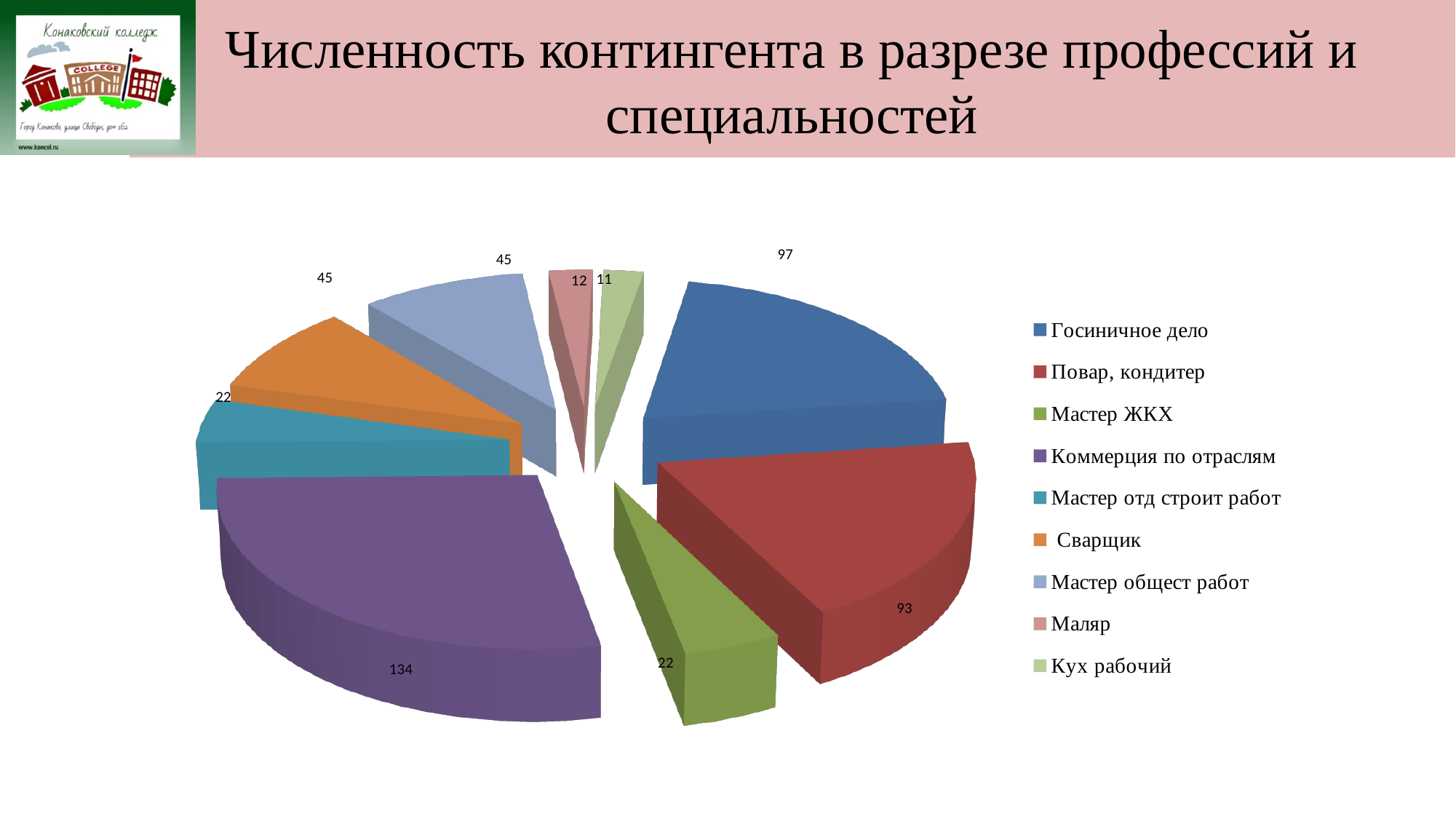
Which is larger, the value for Госиничное дело or the value for Повар, кондитер? Госиничное дело Which category has the smallest slice of the pie? Кух рабочий What is the value for Госиничное дело? 97 What is the difference between the values for Коммерция по отраслям and Госиничное дело? 37 What is the value for Повар, кондитер? 93 What is the value for Коммерция по отраслям? 134 What kind of chart is shown on the slide? Pie chart How many categories does the pie chart have? 9 What is the difference between the values for Сварщик and Мастер ЖКХ? 23 What colour is the slice for Сварщик? Orange What is the value for Маляр? 12 Which category has the largest slice of the pie? Коммерция по отраслям